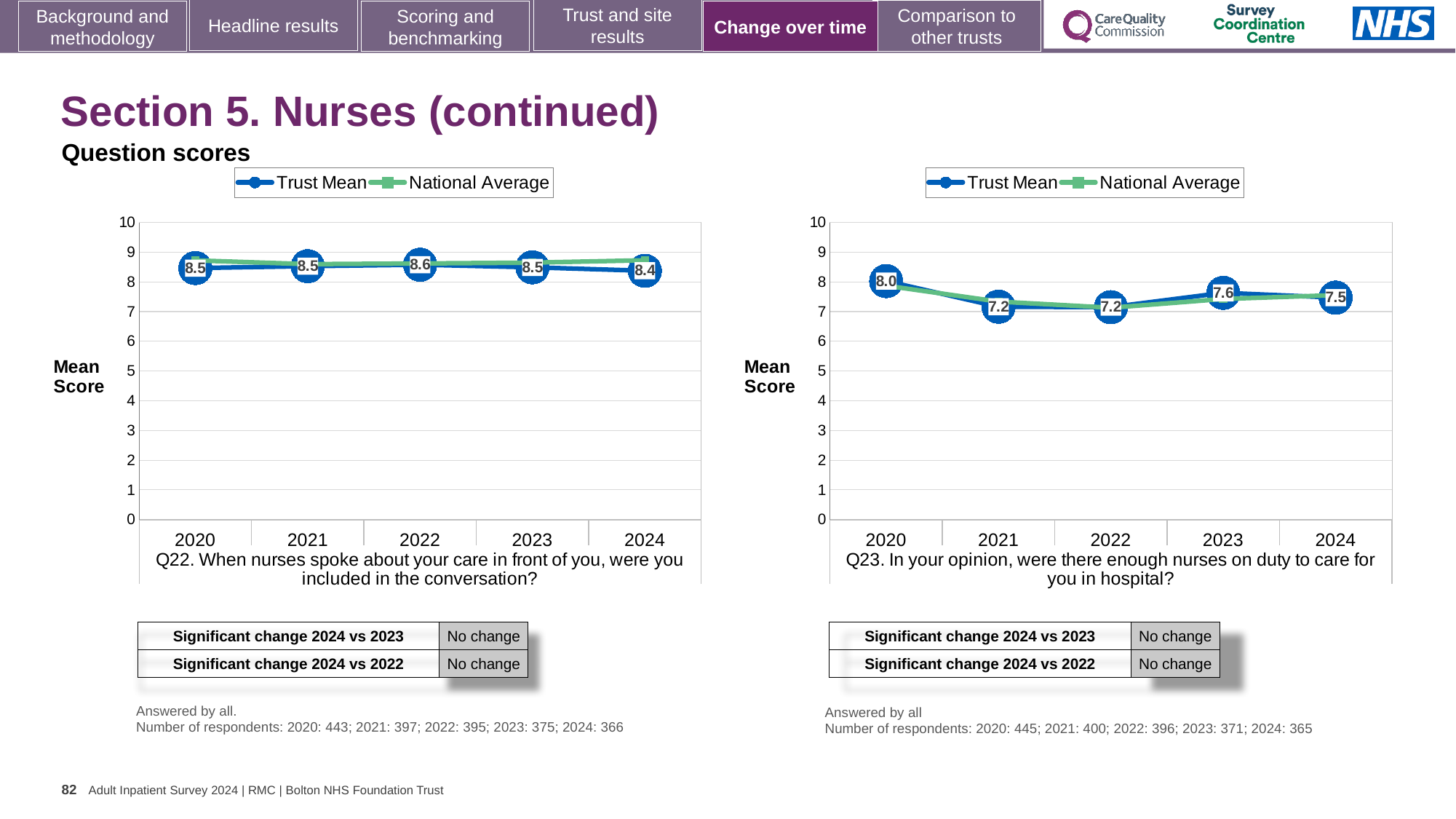
On the Q23 chart (right), is the Trust Mean score for 2023 larger or smaller than the score for 2024? larger On the Q22 chart (left), which year has the lowest Trust Mean score? 2024 On the Q22 chart (left), what is the Trust Mean score for 2024? 8.4 How many series does the legend of the Q23 chart (right) list? 2 What kind of chart is the Q22 chart (left)? Line chart On the Q23 chart (right), which year has the highest Trust Mean score? 2020 On the Q23 chart (right), what is the difference between the Trust Mean scores for 2020 and 2021? 0.8 On the Q23 chart (right), does the Trust Mean score rise or fall from 2020 to 2021? fall On the Q23 chart (right), what is the Trust Mean score for 2020? 8.0 How many years are plotted on the x axis of the Q22 chart (left)? 5 On the Q22 chart (left), what is the Trust Mean score for 2022? 8.6 On the Q23 chart (right), what is the Trust Mean score for 2023? 7.6